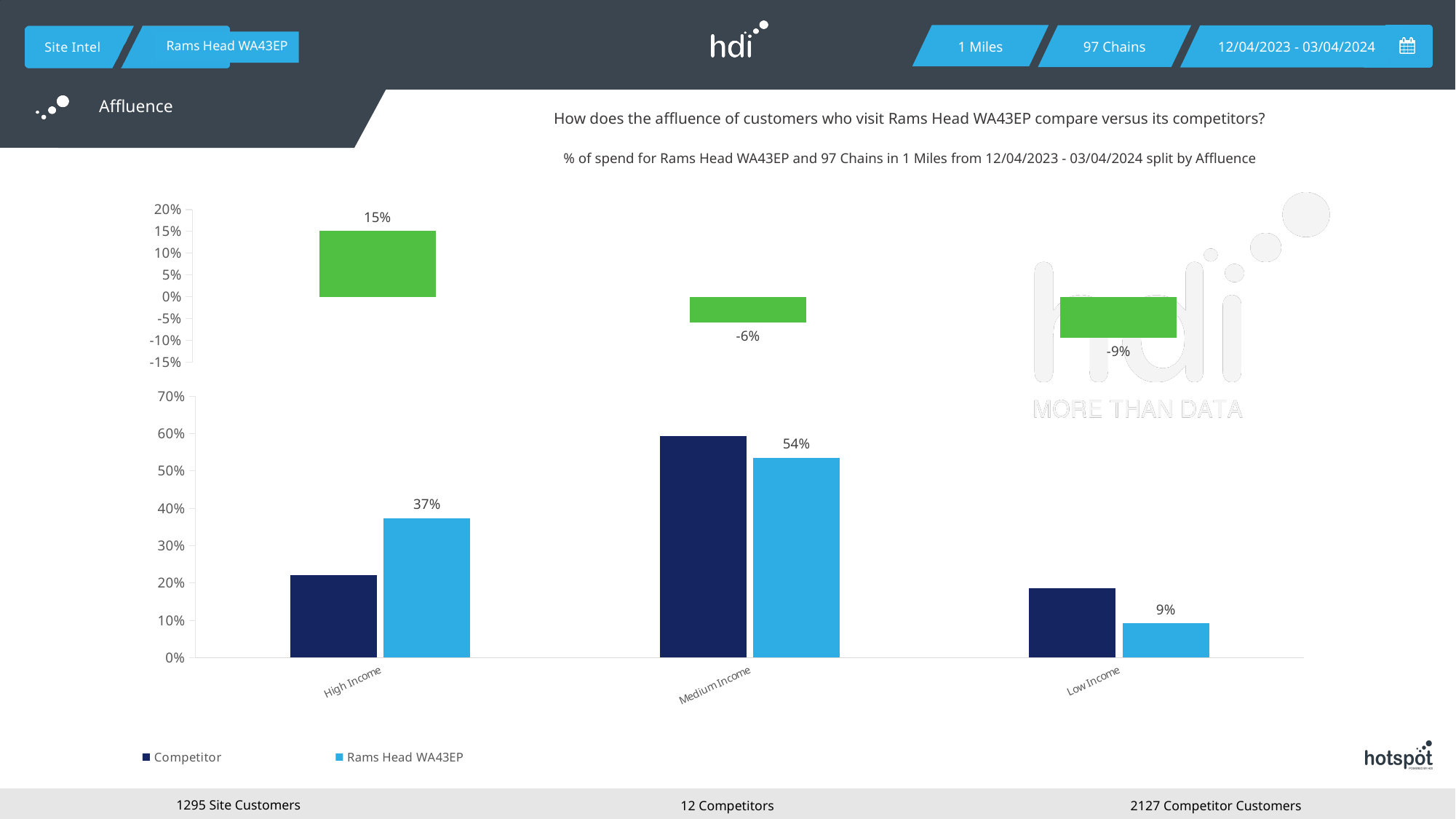
In the top chart, what is the value shown for the High Income category? 15% What kind of chart is the bottom chart? Bar chart In the top chart, what is the value shown for the Low Income category? -9% In the bottom chart, what is the value for Rams Head WA43EP in the Medium Income category? 54% In the bottom chart, what is the value for Rams Head WA43EP in the High Income category? 37% In the bottom chart, which category has the highest value for Rams Head WA43EP? Medium Income In the top chart, which category has the lowest value? Low Income How many series does the legend of the bottom chart list? 2 In the bottom chart, is the Competitor value for Medium Income greater or less than 50%? greater In the bottom chart, what is the value for Rams Head WA43EP in the Low Income category? 9% In the bottom chart, which is larger for High Income: the Competitor value or the Rams Head WA43EP value? Rams Head WA43EP In the bottom chart, what is the difference between the Rams Head WA43EP values for Medium Income and High Income? 17%